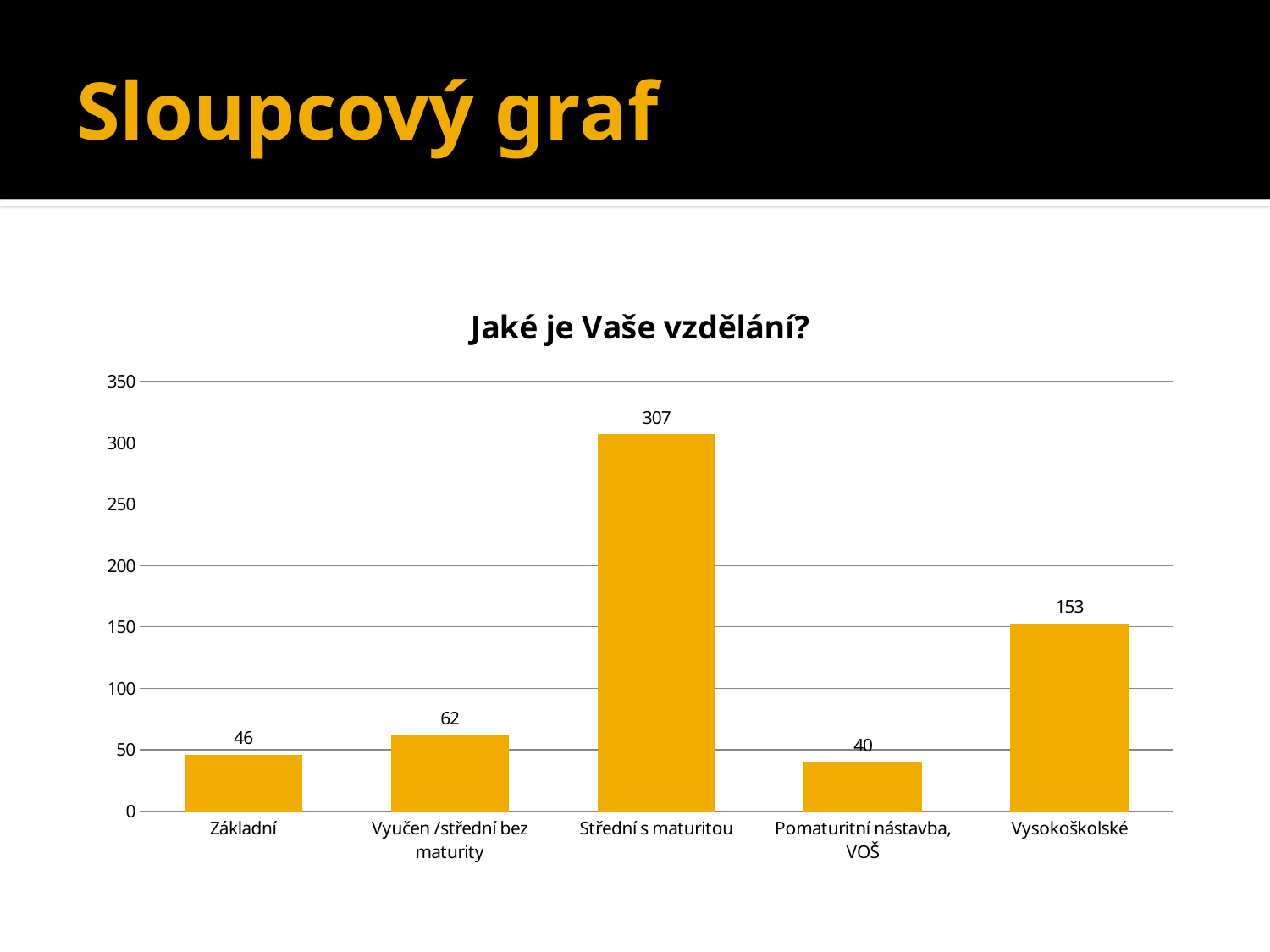
Which category has the lowest value? Pomaturitní nástavba, VOŠ What is the difference between the values for Vyučen /střední bez maturity and Základní? 16 Is the value for Vysokoškolské greater or less than 100? greater What is the value for Střední s maturitou? 307 What is the value for Základní? 46 How many categories are shown on the x axis? 5 Which category has the highest value? Střední s maturitou What kind of chart is shown on the slide? bar chart What is the difference between the values for Střední s maturitou and Vysokoškolské? 154 Which is larger, the value for Základní or the value for Pomaturitní nástavba, VOŠ? Základní What is the value for Vysokoškolské? 153 What is the title of the chart? Jaké je Vaše vzdělání?